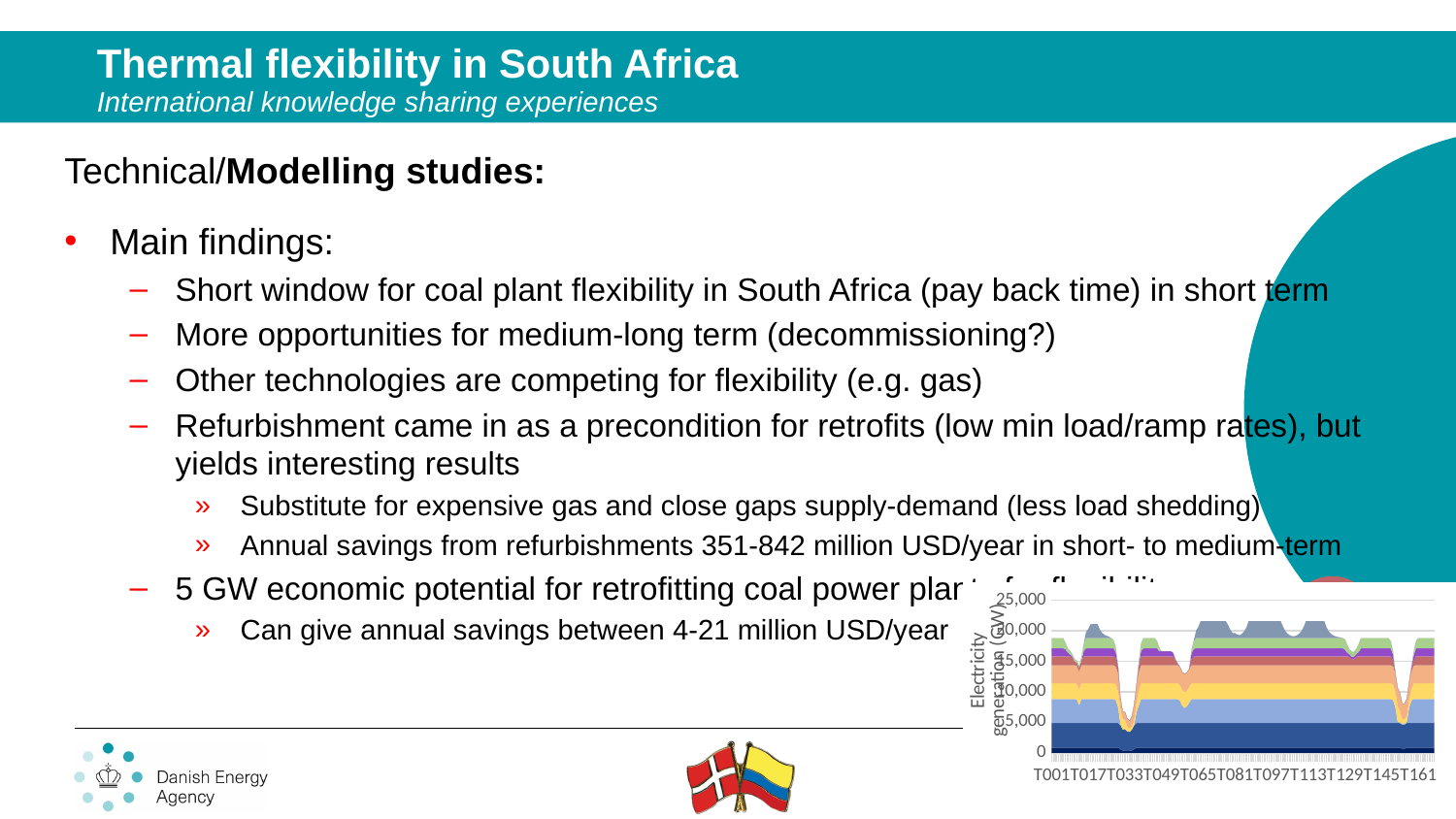
What is the first label on the horizontal axis of the chart in the bottom right? T001 What is the highest value shown on the vertical axis of the chart in the bottom right? 25,000 In the chart in the bottom right, is the total stacked value at T001 greater or less than 25,000? less How many labels are printed along the horizontal axis of the chart in the bottom right? 11 In the chart in the bottom right, is the total stacked value at T001 greater or less than 15,000? greater What is the lowest value shown on the vertical axis of the chart in the bottom right? 0 What is the last label on the horizontal axis of the chart in the bottom right? T161 In the chart in the bottom right, is the total stacked value at T161 greater or less than 10,000? greater What is the label on the vertical axis of the chart in the bottom right? Electricity generation (GW) What kind of chart is shown in the bottom right of the slide? stacked area chart